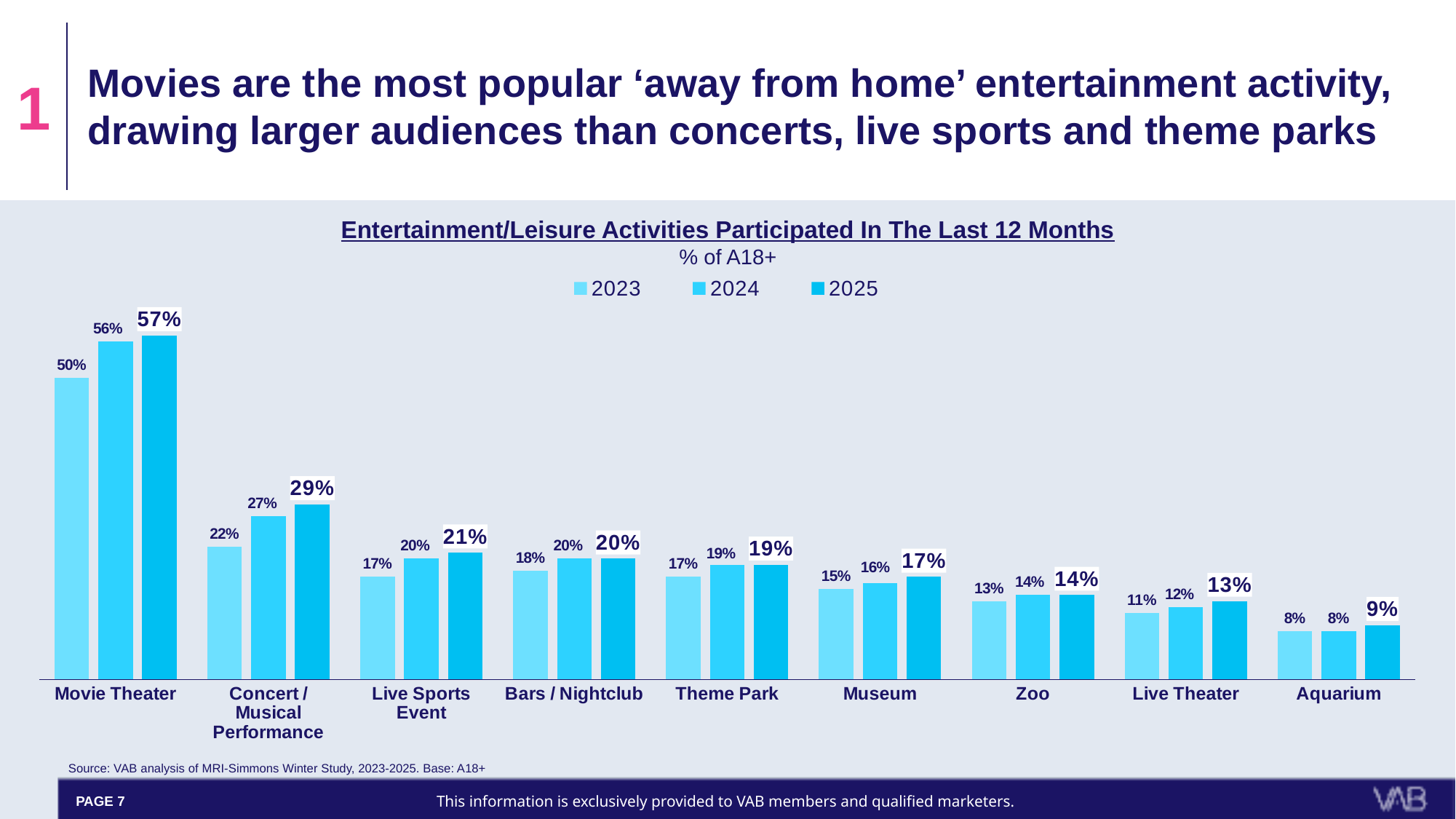
What is the title of the chart? Entertainment/Leisure Activities Participated In The Last 12 Months Which category has the lowest 2023 value? Aquarium What is the difference between the 2025 values for Concert / Musical Performance and Live Sports Event? 8% What is the 2024 value for Zoo? 14% What is the 2023 value for Concert / Musical Performance? 22% What is the difference between the 2025 and 2023 values for Movie Theater? 7% Which is larger, the 2025 value for Theme Park or the 2025 value for Museum? Theme Park Which category has the highest 2025 value? Movie Theater What kind of chart is shown on the slide? Bar chart How many series does the legend list? 3 How many categories are shown on the x axis? 9 What is the 2025 value for Movie Theater? 57%